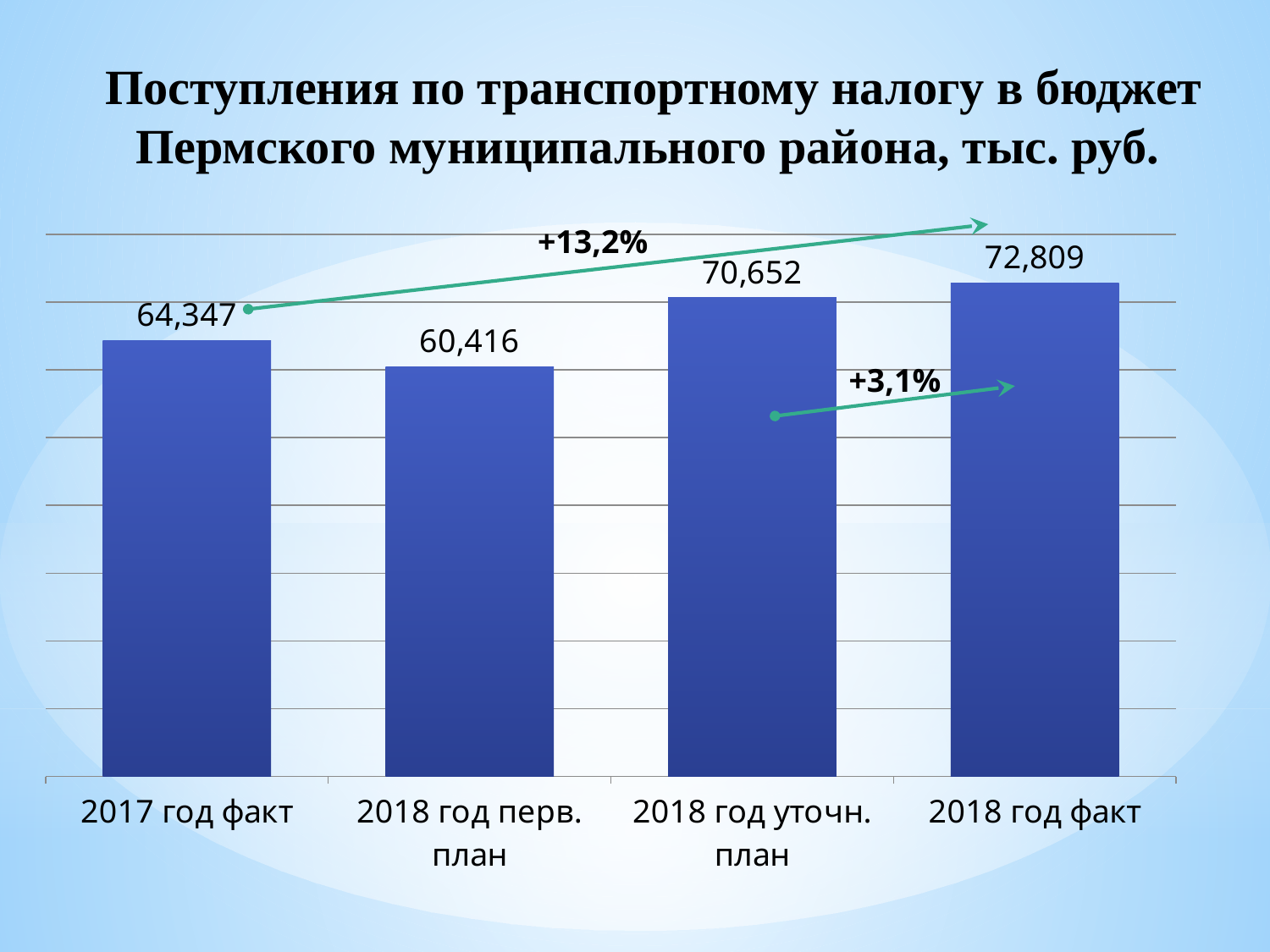
What is the value for 2017 год факт? 64,347 What is the value for 2018 год факт? 72,809 What percentage change is shown by the arrow from 2017 год факт to 2018 год факт? +13,2% What is the value for 2018 год перв. план? 60,416 What is the difference between the values for 2018 год факт and 2017 год факт? 8,462 Which is larger, the value for 2017 год факт or the value for 2018 год перв. план? 2017 год факт What is the difference between the values for 2018 год уточн. план and 2018 год перв. план? 10,236 Which category has the lowest value? 2018 год перв. план Which category has the highest value? 2018 год факт What kind of chart is shown on the slide? Bar chart What is the value for 2018 год уточн. план? 70,652 How many categories are shown in the chart? 4